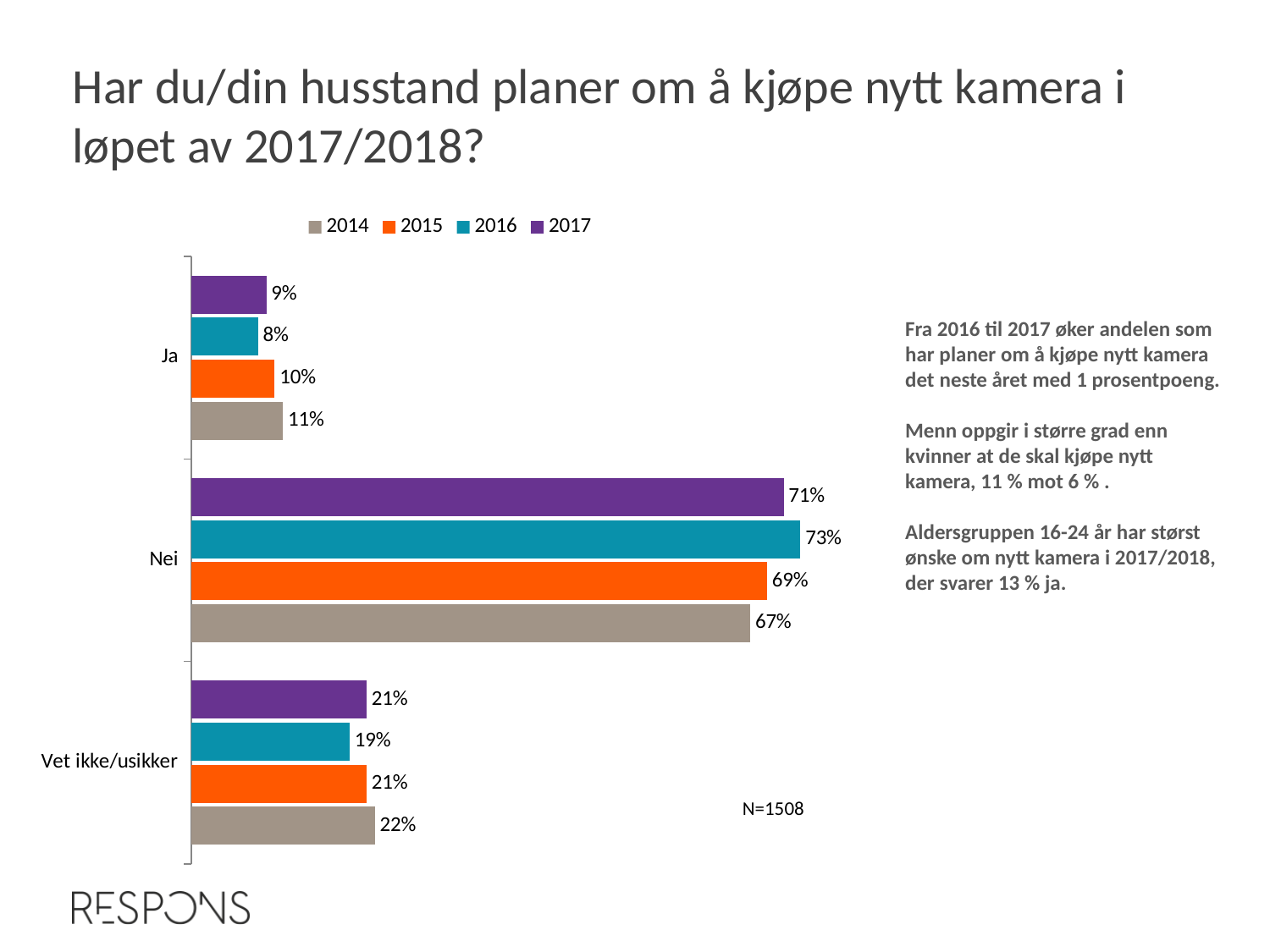
What is the value for "Ja" in the 2017 series? 9% What is the difference between the 2016 and 2014 values for "Nei"? 6% What kind of chart is shown on the slide? Bar chart What is the difference between the 2017 and 2016 values for "Ja"? 1% What is the value for "Vet ikke/usikker" in the 2014 series? 22% What is the value for "Nei" in the 2015 series? 69% How many series does the legend list? 4 Which year has the highest value for "Nei"? 2016 Which year has the lowest value for "Ja"? 2016 What is the value for "Nei" in the 2016 series? 73% How many categories are shown on the chart? 3 Which is larger: the 2014 value for "Ja" or the 2017 value for "Ja"? 2014